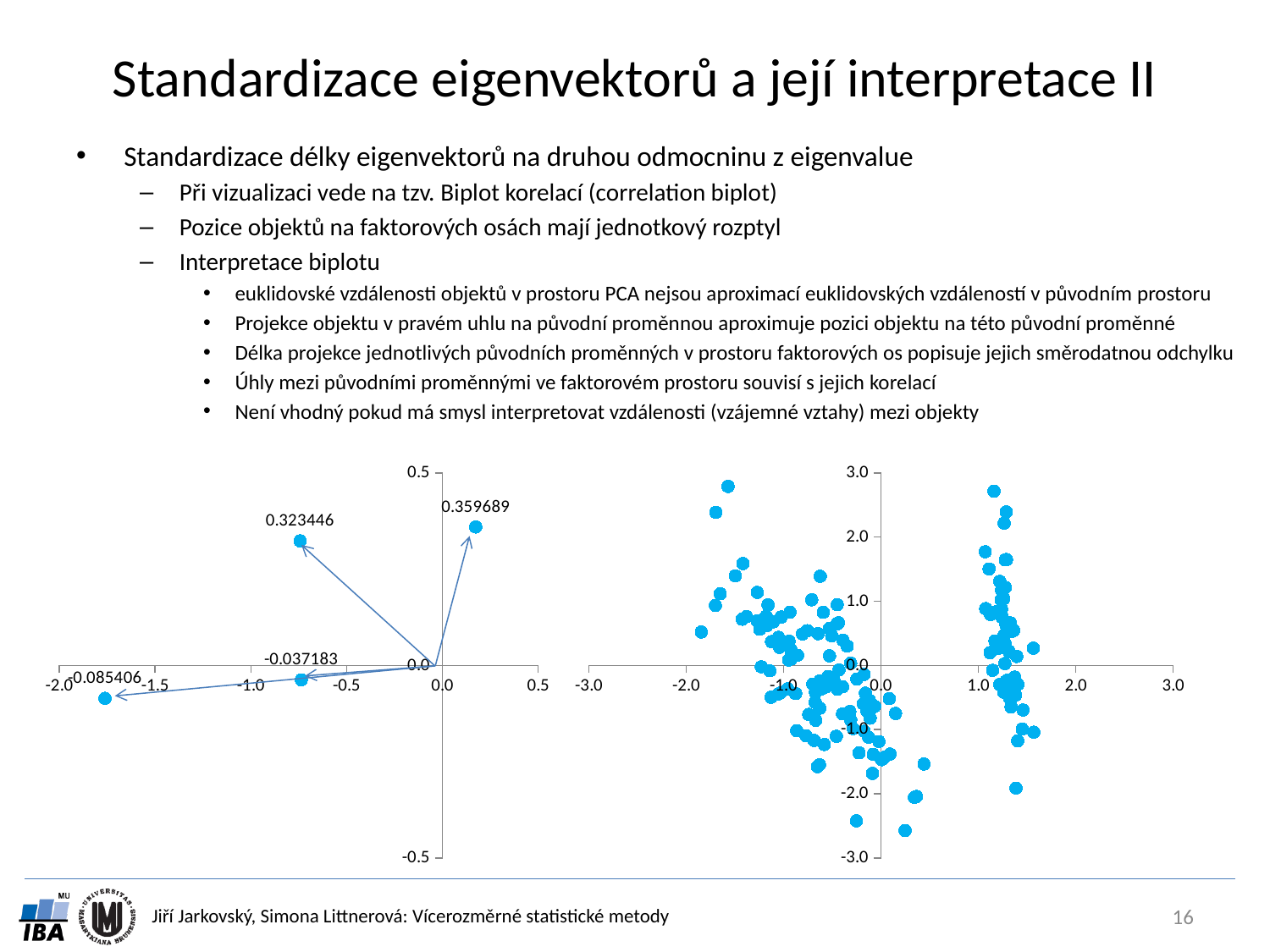
In the left chart, what is the minimum value shown on the horizontal axis? -2.0 What kind of chart is the right chart on the slide? scatter chart In the left chart, what is the largest data label value shown? 0.359689 In the left chart, what is the smallest data label value shown? -0.085406 In the right chart, what is the maximum value shown on the vertical axis? 3.0 In the left chart, which data label is larger: 0.323446 or -0.037183? 0.323446 In the left chart, what is the difference between the data labels 0.359689 and 0.323446? 0.036243 In the left chart, is the x-coordinate of the point labelled -0.085406 greater or less than -1.5? less In the left chart, is the x-coordinate of the point labelled 0.359689 greater or less than 0.0? greater In the left chart, how many data points (arrow endpoints) are plotted? 4 What kind of chart is the left chart on the slide? scatter chart In the right chart, is the y-coordinate of the highest point greater or less than 2.5? greater